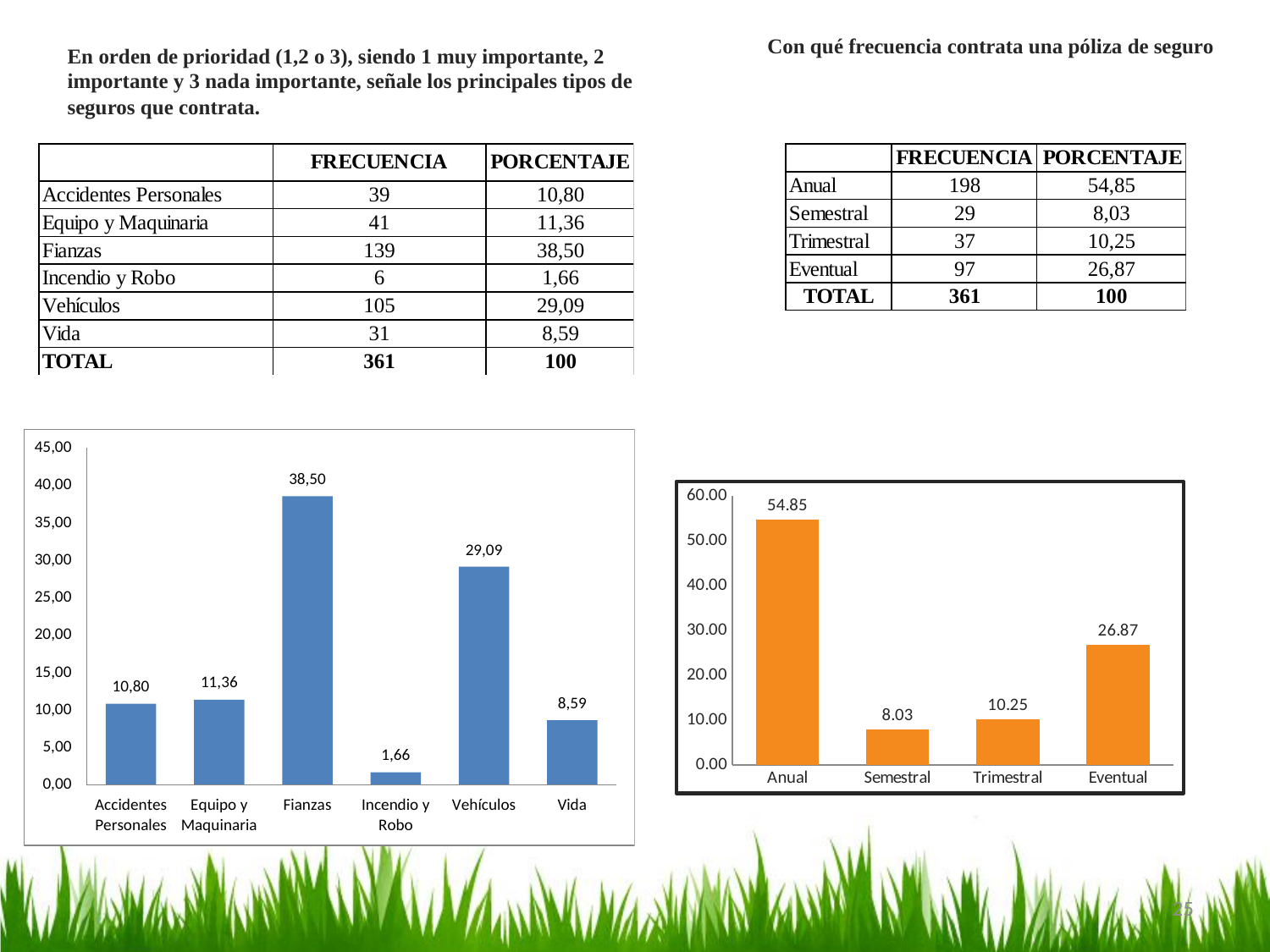
In the left chart, what is the value for Fianzas? 38,50 In the right chart, which category has the lowest value? Semestral In the left chart, what is the difference between the values for Fianzas and Vehículos? 9,41 In the left chart, what is the value for Incendio y Robo? 1,66 In the right chart, what is the value for Eventual? 26.87 In the left chart, how many categories are shown on the x axis? 6 In the right chart, what is the difference between the values for Anual and Eventual? 27.98 In the right chart, what is the value for Anual? 54.85 In the left chart, which category has the lowest value? Incendio y Robo What type of chart is the right chart? Bar chart In the left chart, which category has the highest value? Fianzas In the left chart, is the value for Vehículos greater or less than 25,00? greater